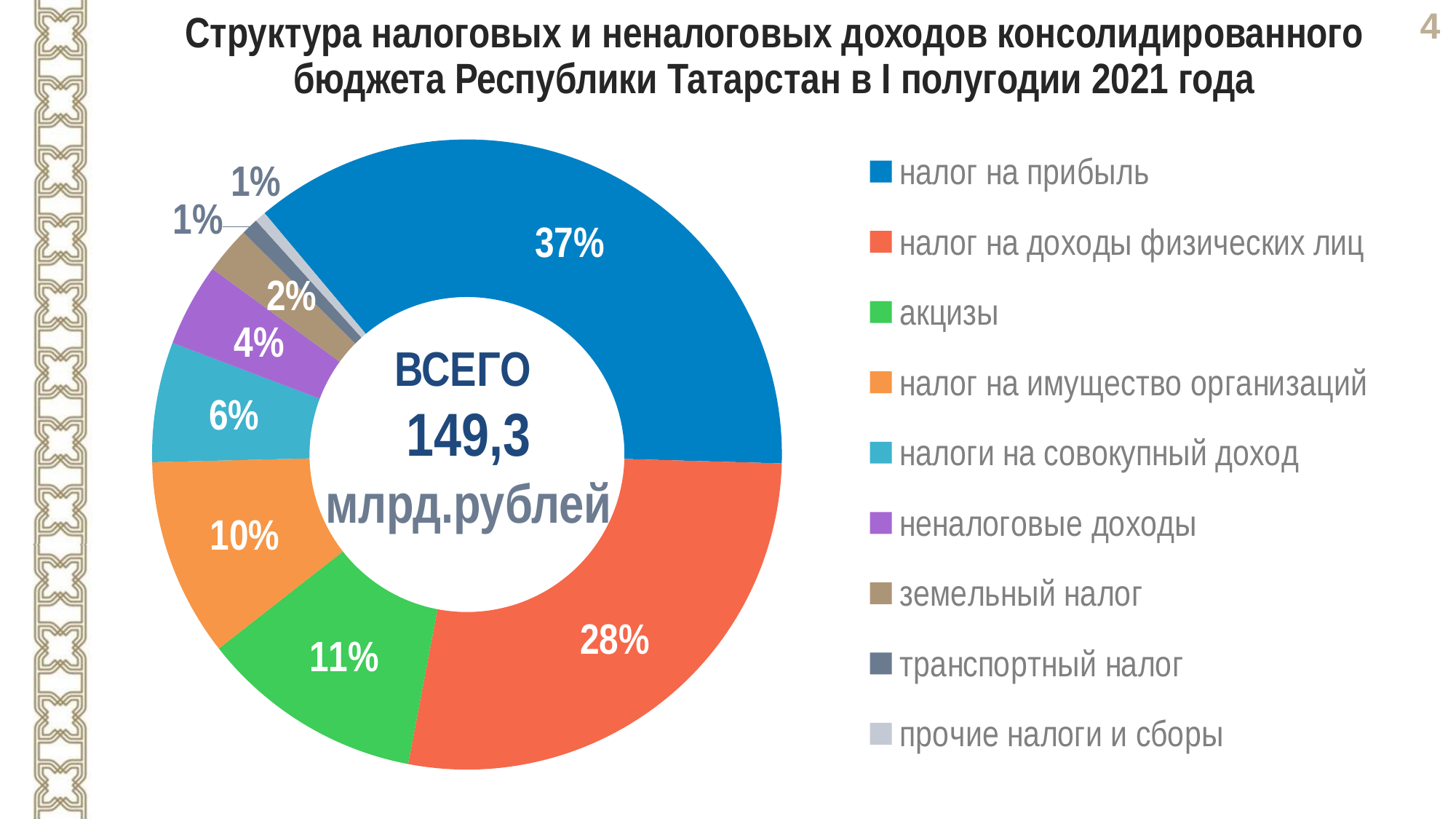
Сколько категорий перечислено в легенде диаграммы? 9 Что больше: доля акцизов или доля налогов на совокупный доход? акцизы Какую долю составляют акцизы? 11% Какую долю составляет налог на прибыль в структуре доходов? 37% На сколько процентных пунктов доля налога на прибыль больше доли налога на доходы физических лиц? 9 Каким цветом на диаграмме обозначен земельный налог? коричневым (бежевым) Какая общая сумма доходов указана в центре диаграммы? 149,3 млрд.рублей Какую долю составляет налог на доходы физических лиц? 28% Какой тип диаграммы показан на слайде? круговая (кольцевая) диаграмма Какая категория имеет наибольшую долю в структуре доходов? налог на прибыль